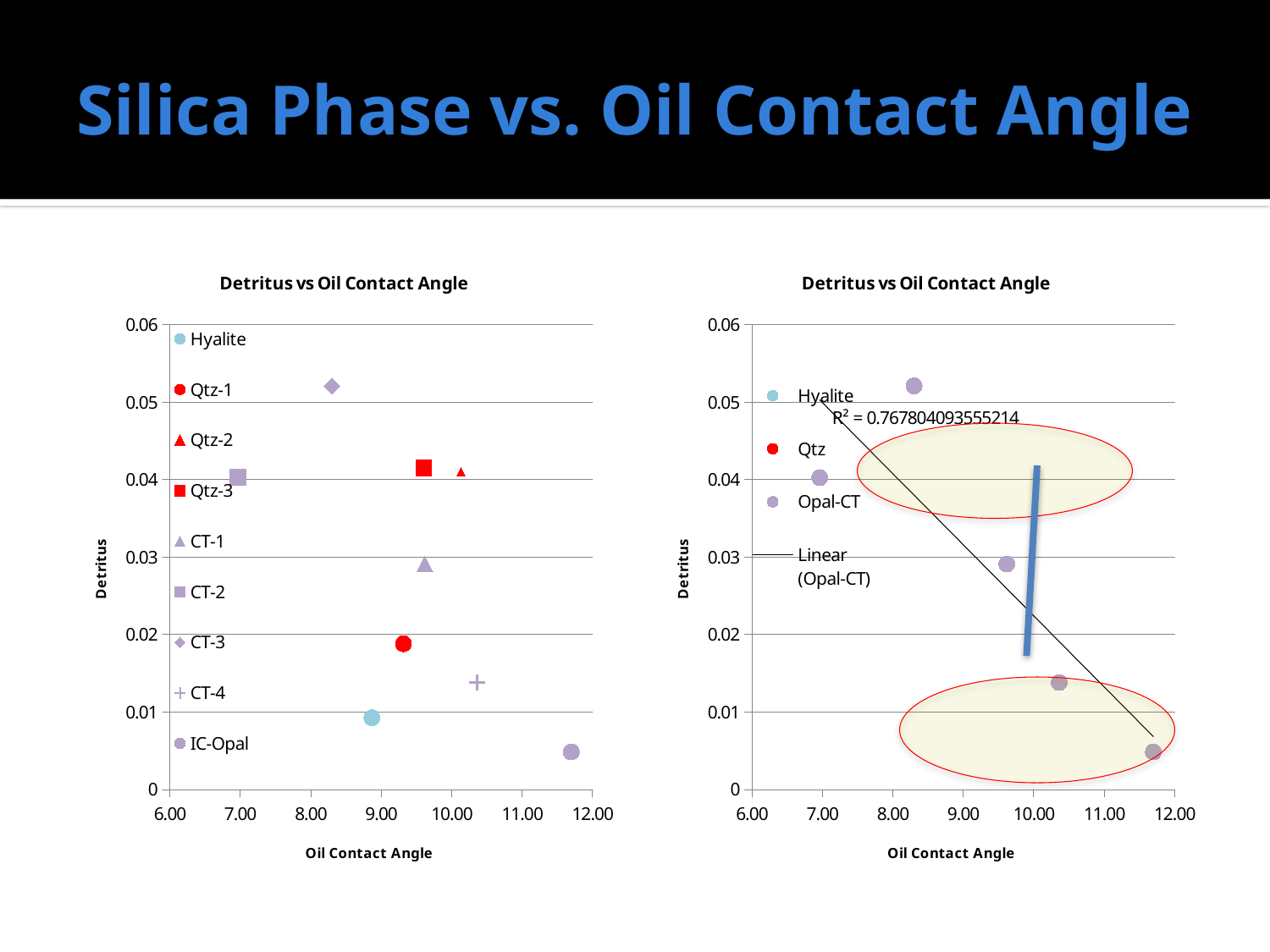
In the left chart, which series has the lowest Oil Contact Angle? CT-2 What kind of chart is the left chart titled 'Detritus vs Oil Contact Angle'? scatter chart In the left chart, is the Detritus value for CT-3 greater or less than 0.05? greater In the right chart, does the Linear (Opal-CT) trendline rise or fall as Oil Contact Angle increases? fall In the right chart, how many entries does the legend list? 4 In the left chart, which series has the highest Detritus value? CT-3 In the left chart, which has the higher Detritus value, CT-3 or CT-1? CT-3 In the left chart, how many series does the legend list? 9 What R² value is shown on the right chart? R² = 0.767804093555214 In the left chart, is the Detritus value for IC-Opal greater or less than 0.01? less In the left chart, which series has the highest Oil Contact Angle? IC-Opal In the left chart, which series has the lowest Detritus value? IC-Opal